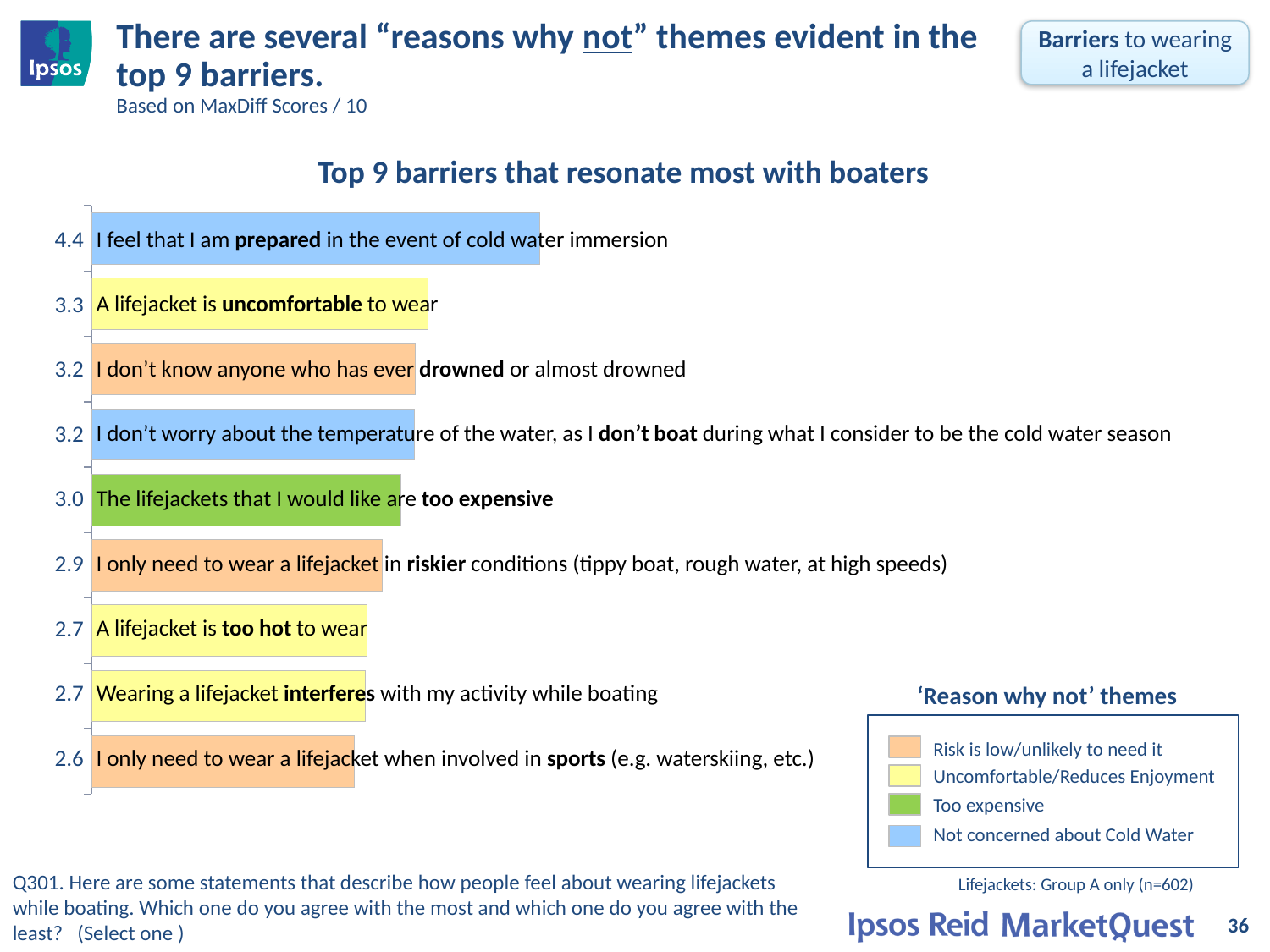
Which theme colour is used for "The lifejackets that I would like are too expensive"? Green (Too expensive) How many barriers are shown in the chart? 9 What type of chart is shown on the slide? Bar chart How many 'Reason why not' themes does the legend list? 4 What is the MaxDiff score for "I feel that I am prepared in the event of cold water immersion"? 4.4 Which barrier has the highest score? I feel that I am prepared in the event of cold water immersion What is the score for "The lifejackets that I would like are too expensive"? 3.0 Which barrier has the lowest score? I only need to wear a lifejacket when involved in sports (e.g. waterskiing, etc.) What is the difference between the highest score (4.4) and the lowest score (2.6)? 1.8 Which has a higher score: "A lifejacket is uncomfortable to wear" or "A lifejacket is too hot to wear"? A lifejacket is uncomfortable to wear What is the score for "A lifejacket is uncomfortable to wear"? 3.3 What is the score for "I only need to wear a lifejacket when involved in sports (e.g. waterskiing, etc.)"? 2.6